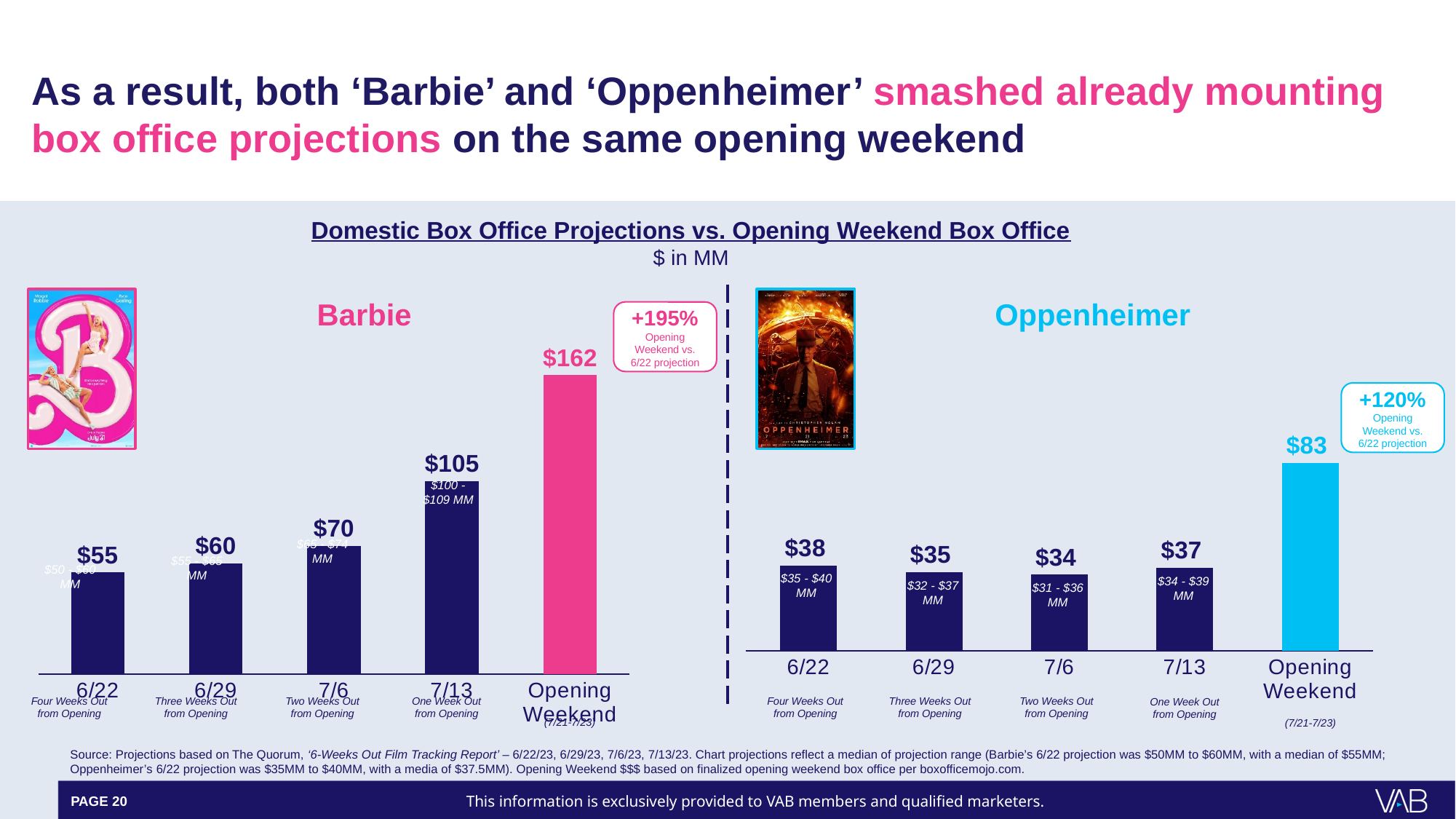
What kind of chart is used for the Barbie data? Bar chart In the Barbie chart, what is the value for the 7/6 projection? $70 In the Oppenheimer chart, which category has the lowest value? 7/6 What percentage increase does the callout box in the Oppenheimer chart show for Opening Weekend vs. the 6/22 projection? +120% In the Barbie chart, what is the value for the Opening Weekend bar? $162 In the Barbie chart, which category has the highest value? Opening Weekend How many bars are in the Oppenheimer chart? 5 In the Barbie chart, what is the difference between the Opening Weekend value and the 7/13 projection? $57 In the Oppenheimer chart, what is the value for the 7/13 projection? $37 In the Oppenheimer chart, what is the difference between the Opening Weekend value and the 6/22 projection? $45 Which is larger: the Barbie 6/22 projection or the Oppenheimer 6/22 projection? Barbie 6/22 projection In the Barbie chart, do the values rise or fall from 6/22 to Opening Weekend? Rise